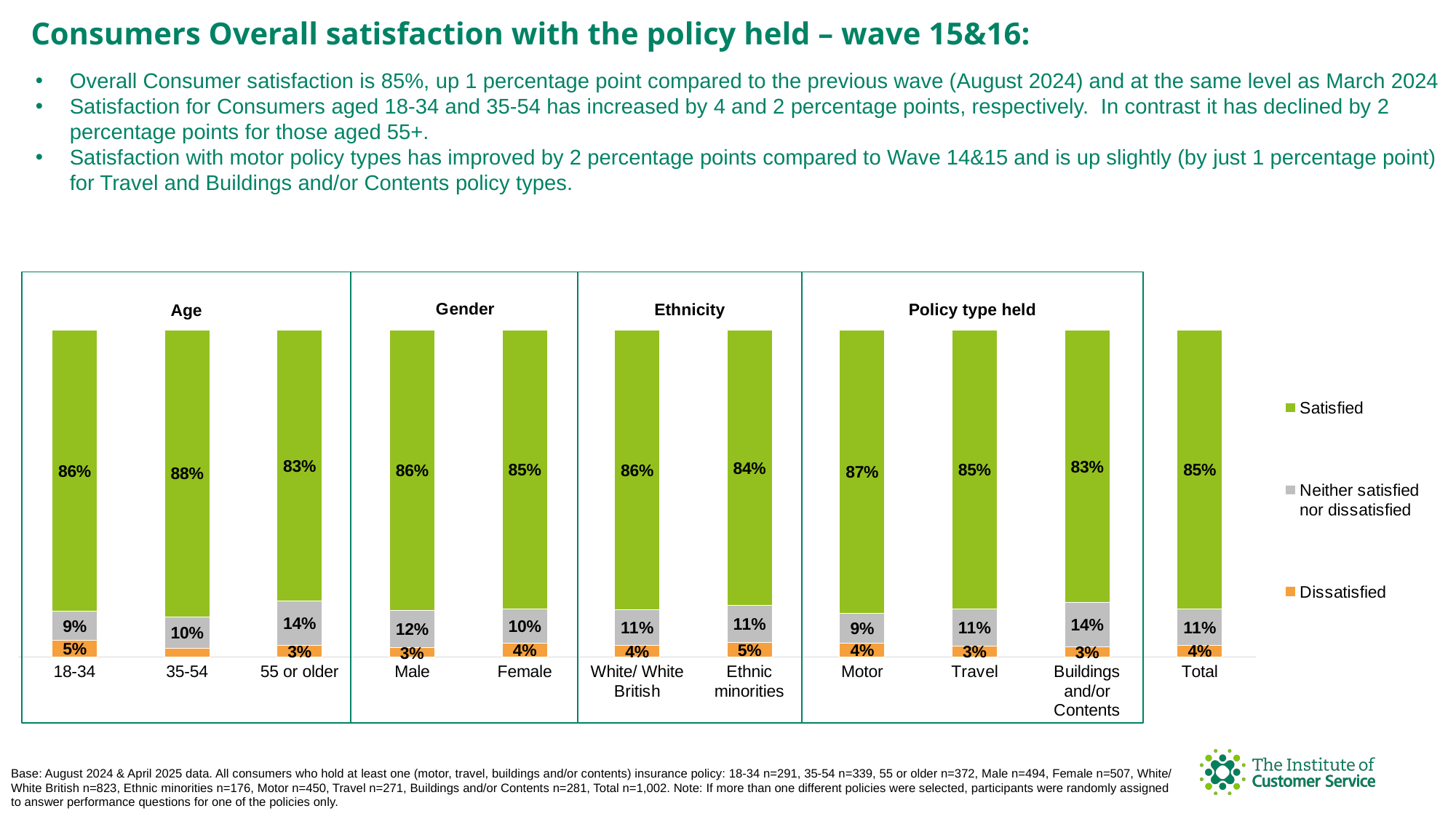
Which has a higher Neither satisfied nor dissatisfied value, Male or Female? Male What is the Satisfied value for Total? 85% What kind of chart is shown on the slide? Stacked bar chart Which category has the highest Satisfied value? 35-54 Which colour represents the Dissatisfied series? Orange How many categories are shown along the x axis? 11 What is the Dissatisfied value for Ethnic minorities? 5% What is the Neither satisfied nor dissatisfied value for Buildings and/or Contents? 14% Which category has the lowest Satisfied value among the Policy type held group? Buildings and/or Contents What is the Satisfied value for the 35-54 age group? 88% How many series does the legend list? 3 What is the difference between the Satisfied values for 35-54 and 55 or older? 5 percentage points